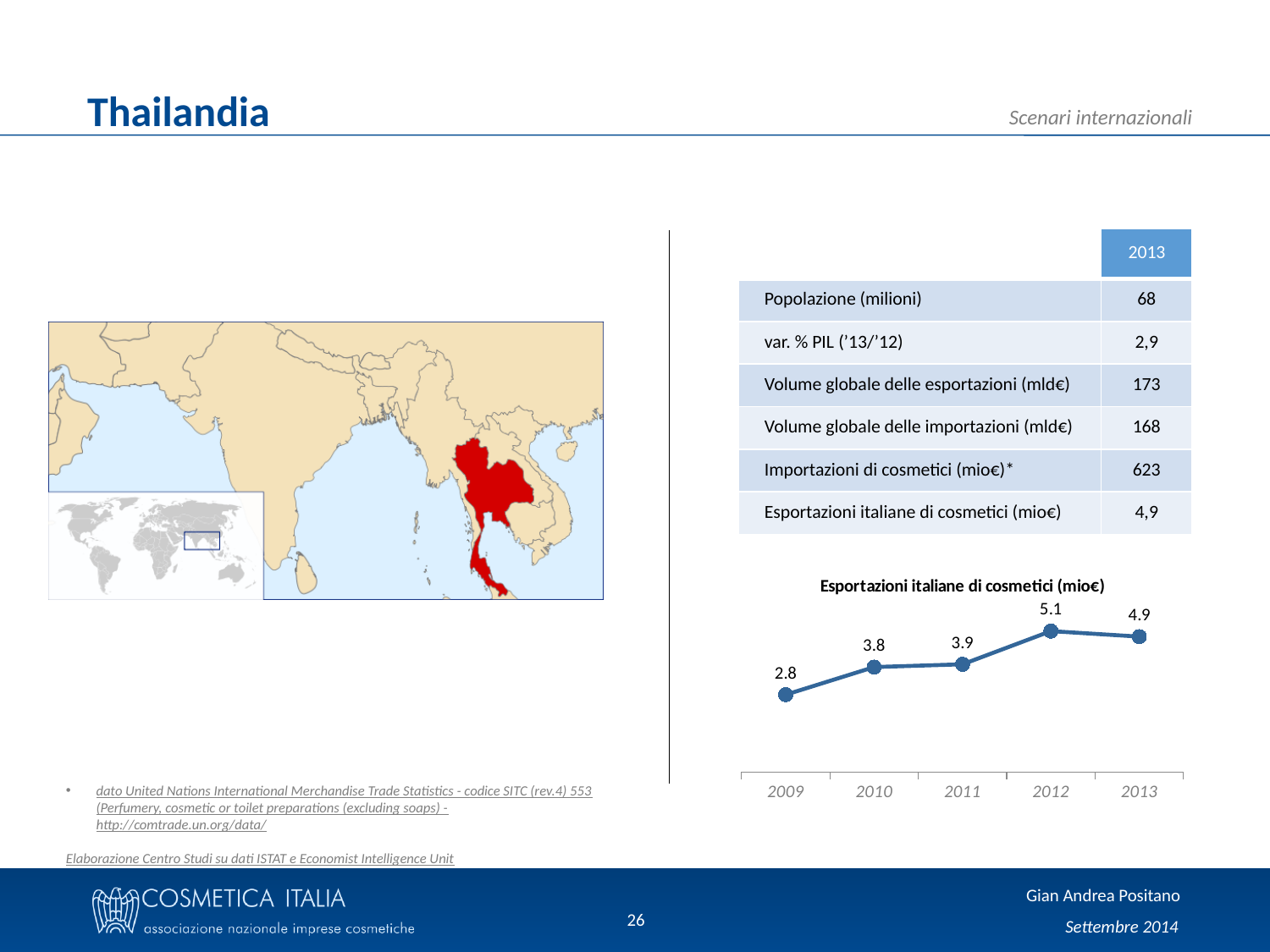
What is the value for 2010 in the chart 'Esportazioni italiane di cosmetici (mio€)'? 3.8 What is the value for 2009 in the chart 'Esportazioni italiane di cosmetici (mio€)'? 2.8 What is the value for 2013 in the chart 'Esportazioni italiane di cosmetici (mio€)'? 4.9 What is the title of the chart on the slide? Esportazioni italiane di cosmetici (mio€) What kind of chart is 'Esportazioni italiane di cosmetici (mio€)'? line chart In the chart 'Esportazioni italiane di cosmetici (mio€)', is the value for 2011 larger or smaller than the value for 2013? smaller What is the value for 2012 in the chart 'Esportazioni italiane di cosmetici (mio€)'? 5.1 In the chart 'Esportazioni italiane di cosmetici (mio€)', do the values rise or fall from 2009 to 2012? rise Which year has the lowest value in the chart 'Esportazioni italiane di cosmetici (mio€)'? 2009 What is the difference between the 2012 and 2009 values in the chart 'Esportazioni italiane di cosmetici (mio€)'? 2.3 How many data points are plotted in the chart 'Esportazioni italiane di cosmetici (mio€)'? 5 Which year has the highest value in the chart 'Esportazioni italiane di cosmetici (mio€)'? 2012